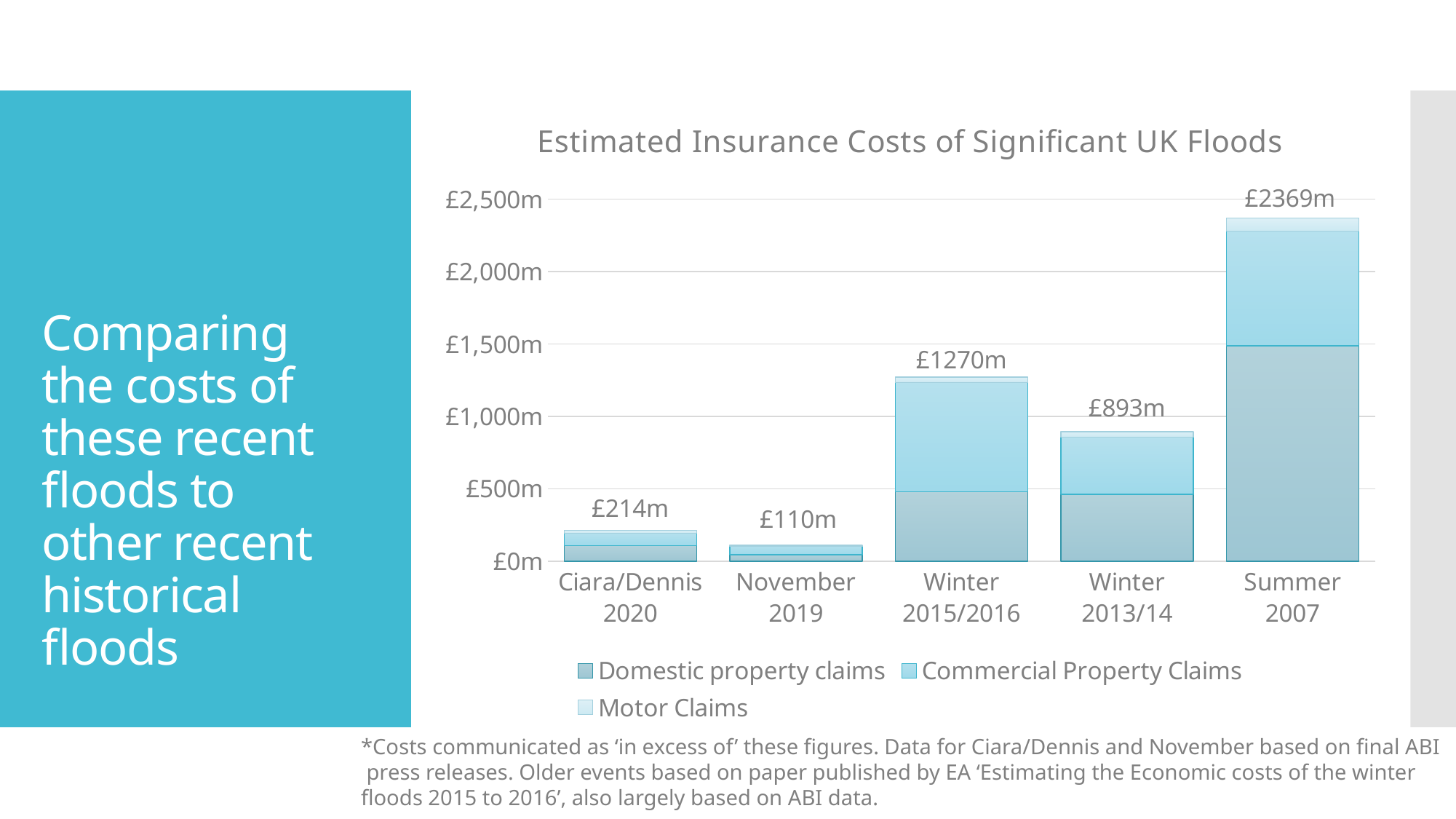
Is the domestic property claims value for Summer 2007 greater or less than £1,000m? greater What is the difference between the total cost of the Winter 2015/2016 floods and the Winter 2013/14 floods? £377m How many flood events are shown on the x axis? 5 What is the total estimated insurance cost shown for the Ciara/Dennis 2020 floods? £214m Which has a larger total estimated insurance cost, Ciara/Dennis 2020 or November 2019? Ciara/Dennis 2020 What kind of chart is shown on the slide? Stacked bar chart How many series does the legend list? 3 Which flood event has the highest total estimated insurance cost? Summer 2007 What is the total estimated insurance cost shown for the Winter 2013/14 floods? £893m What is the total estimated insurance cost shown for the Summer 2007 flood? £2369m Which flood event has the lowest total estimated insurance cost? November 2019 What is the title of the chart? Estimated Insurance Costs of Significant UK Floods